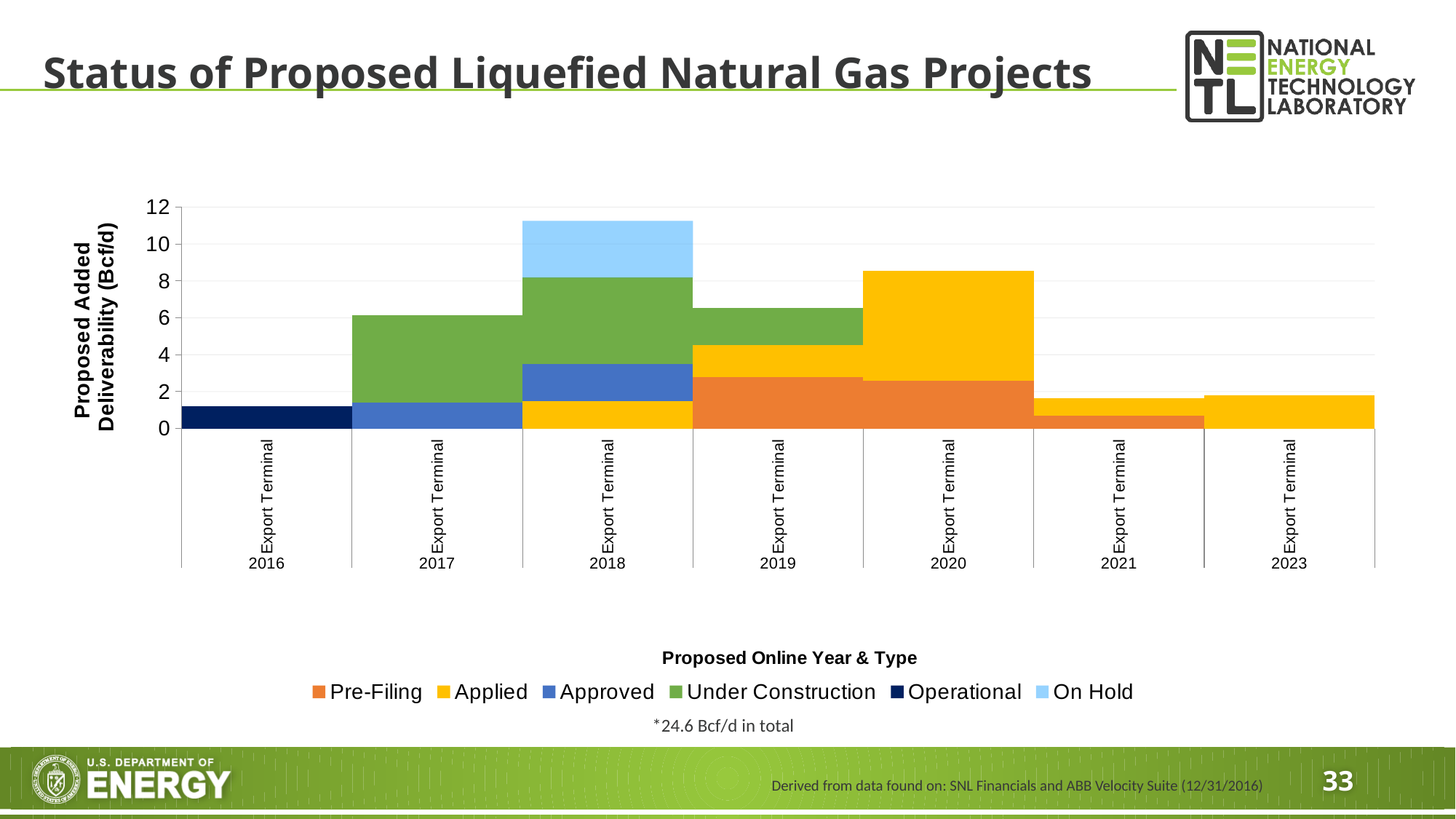
How many year categories are shown on the x axis? 7 Which has the larger total stacked bar, 2018 or 2020? 2018 Which year has the tallest stacked bar? 2018 Which series appears only in the 2016 bar? Operational Which has the larger total stacked bar, 2020 or 2017? 2020 Is the total stacked value for 2018 greater or less than 10? greater How many series does the legend list? 6 What is the title of the x axis? Proposed Online Year & Type Is the total stacked value for 2016 greater or less than 2? less Is the total stacked value for 2020 greater or less than 8? greater What kind of chart is shown on the slide? stacked bar chart